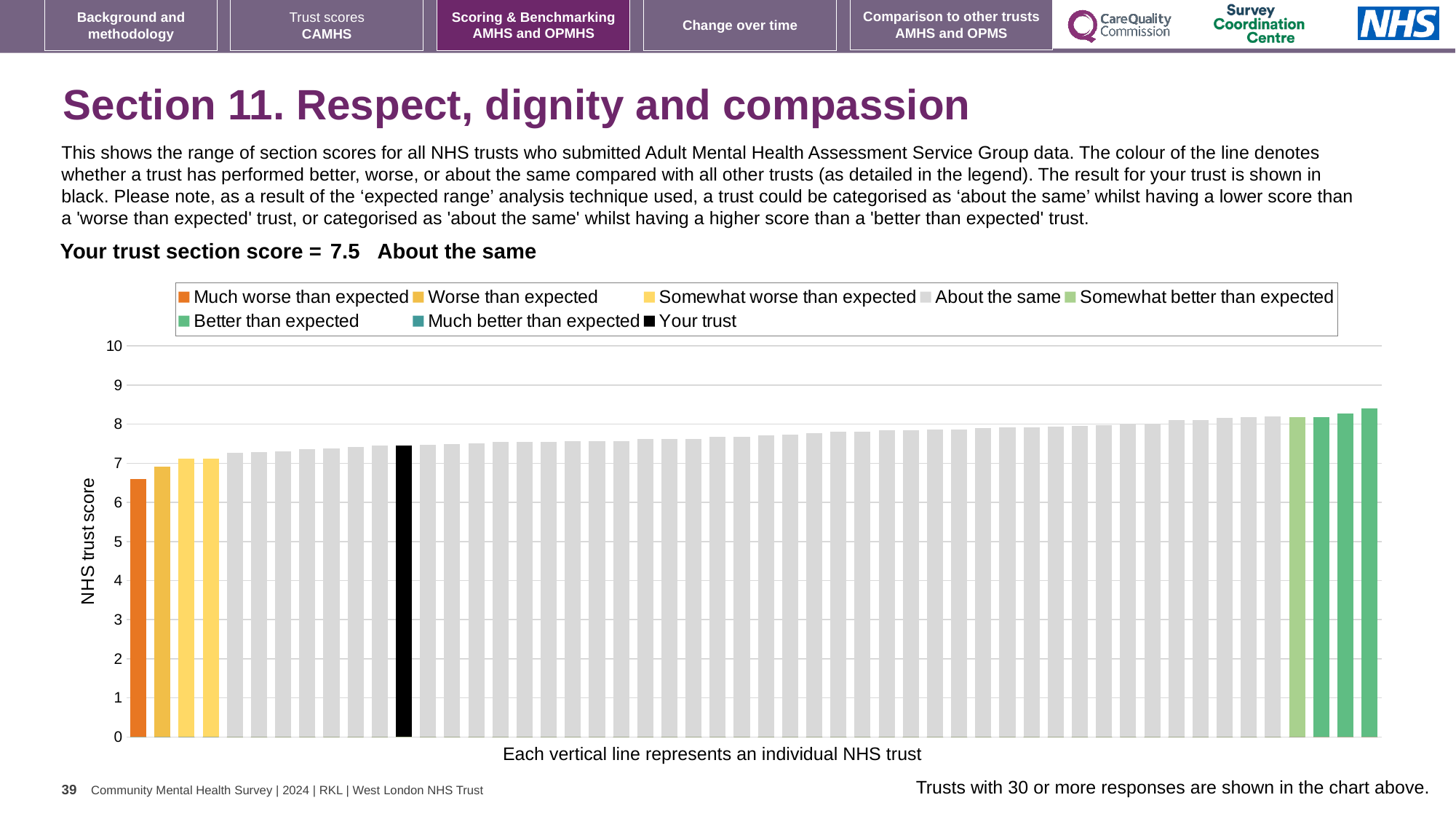
How many entries does the chart legend list? 8 How many bars are coloured as 'Much worse than expected'? 1 Which is larger, the value of the black 'Your trust' bar or the value of the leftmost orange bar? the black 'Your trust' bar Is the value of the black 'Your trust' bar greater or less than 7? greater How many bars are coloured as 'Worse than expected' (yellow)? 1 What is the section score for your trust shown on the slide? 7.5 What colour is used for the 'Your trust' bar? black Is the value of the rightmost bar greater or less than 8? greater Do the bar values rise or fall from left to right along the x axis? rise What kind of chart is shown on the slide? bar chart What is the label of the y axis? NHS trust score Is the value of the leftmost (orange) bar greater or less than 7? less